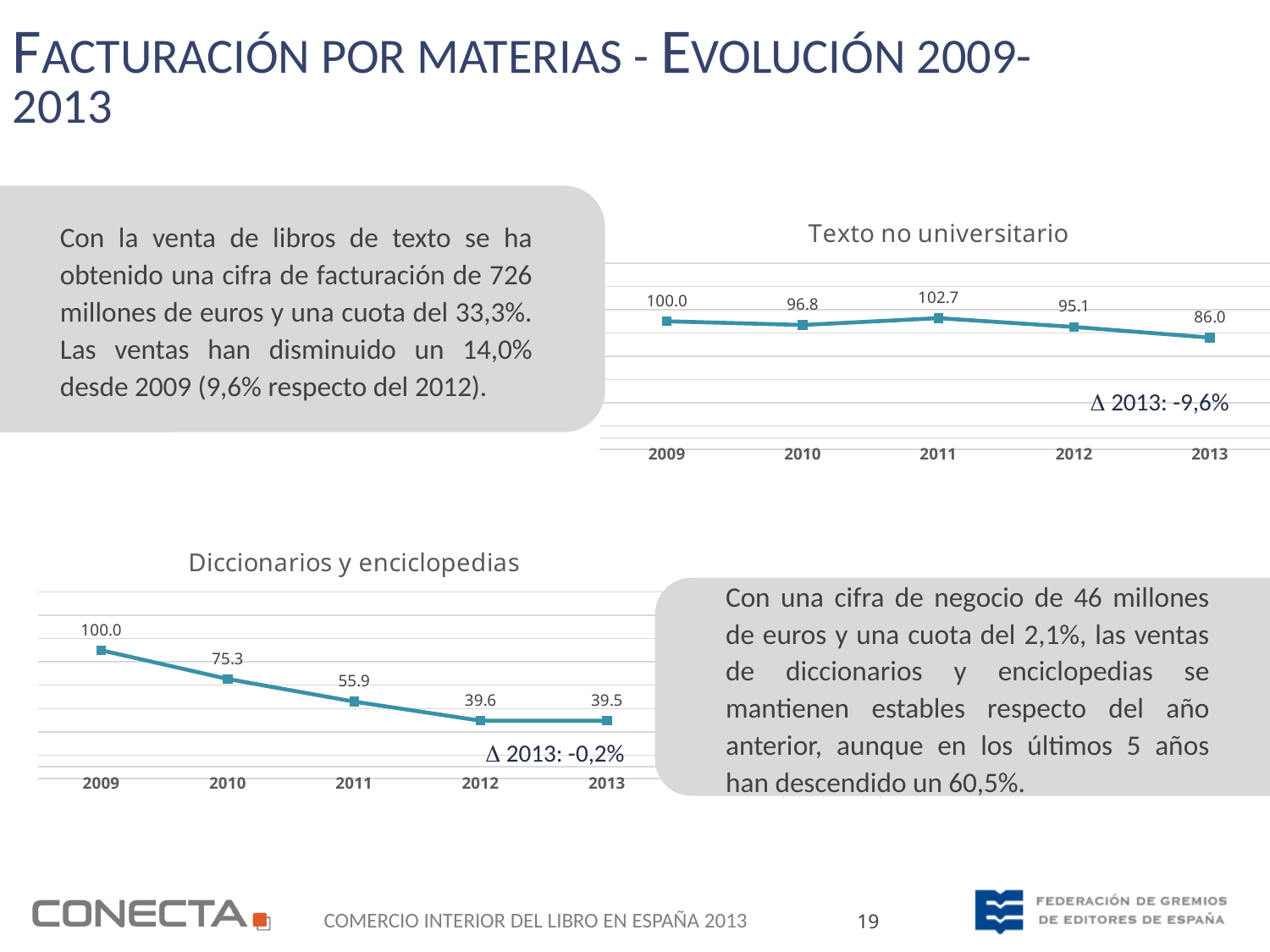
In the 'Texto no universitario' chart, what is the value for 2011? 102.7 In the 'Texto no universitario' chart, which year has the highest value? 2011 In the 'Texto no universitario' chart, what is the value for 2013? 86.0 What kind of chart is the 'Texto no universitario' chart? line chart In the 'Texto no universitario' chart, which year has the lowest value? 2013 In the 'Diccionarios y enciclopedias' chart, what is the value for 2010? 75.3 How many years are plotted in the 'Diccionarios y enciclopedias' chart? 5 In the 'Diccionarios y enciclopedias' chart, do the values rise or fall from 2009 to 2013? fall In the 'Diccionarios y enciclopedias' chart, what is the difference between the values for 2009 and 2011? 44.1 In the 'Texto no universitario' chart, which is larger, the value for 2010 or the value for 2012? 2010 In the 'Texto no universitario' chart, what is the difference between the values for 2009 and 2013? 14.0 In the 'Diccionarios y enciclopedias' chart, what is the value for 2012? 39.6